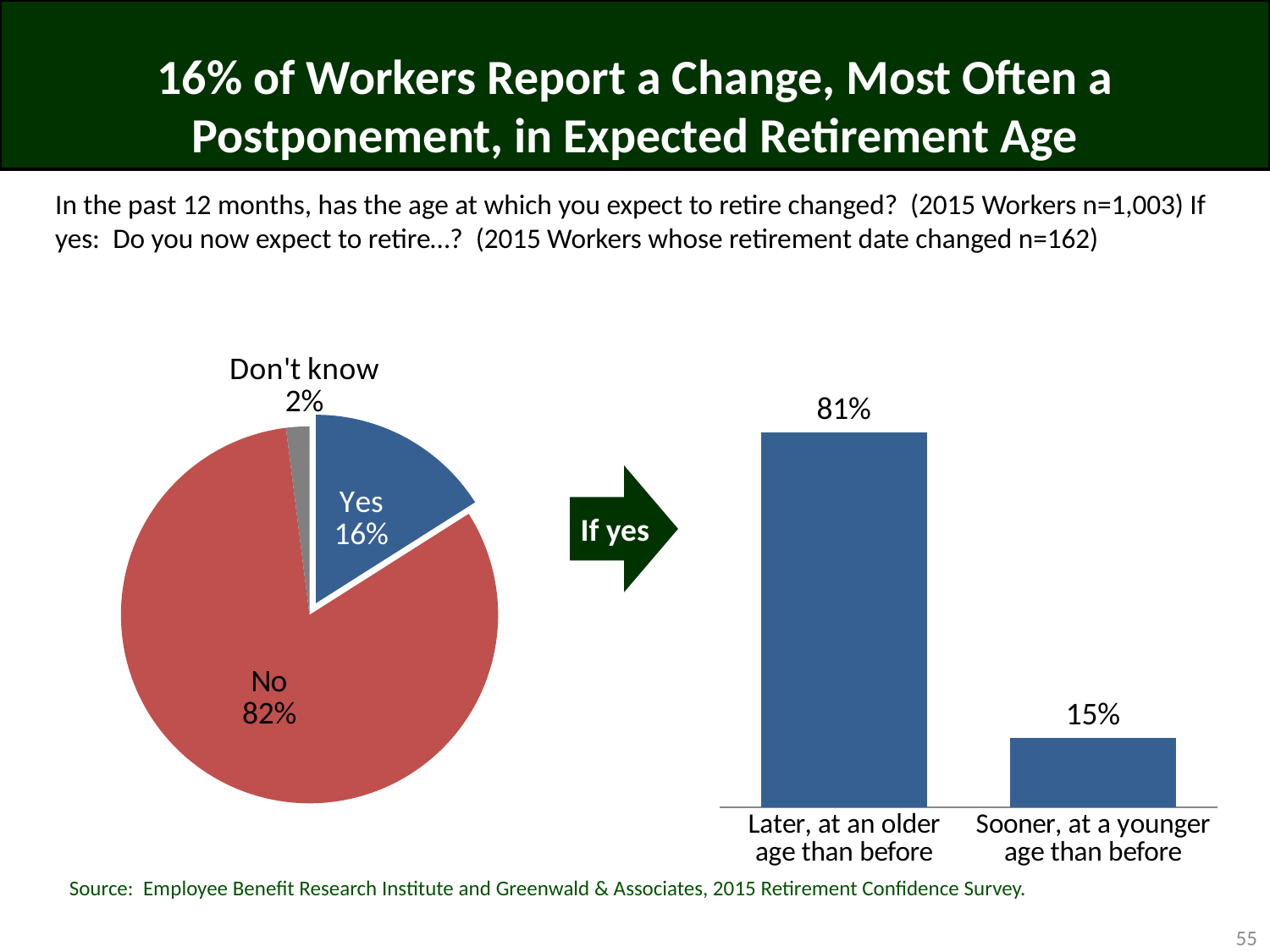
In the bar chart on the right, what is the value for 'Sooner, at a younger age than before'? 15% In the bar chart on the right, which category has the higher value? Later, at an older age than before What type of chart is shown on the left side of the slide? Pie chart In the pie chart on the left, which response has the largest slice? No In the pie chart on the left, which response has the smallest slice? Don't know In the pie chart on the left, what share of workers answered Don't know? 2% In the pie chart on the left, what share of workers answered No? 82% What type of chart is shown on the right side of the slide? Bar chart In the pie chart on the left, what share of workers answered Yes? 16% In the bar chart on the right, what is the value for 'Later, at an older age than before'? 81% In the bar chart on the right, what is the difference between the 'Later, at an older age than before' and 'Sooner, at a younger age than before' values? 66 percentage points In the pie chart on the left, how many slices are there? 3